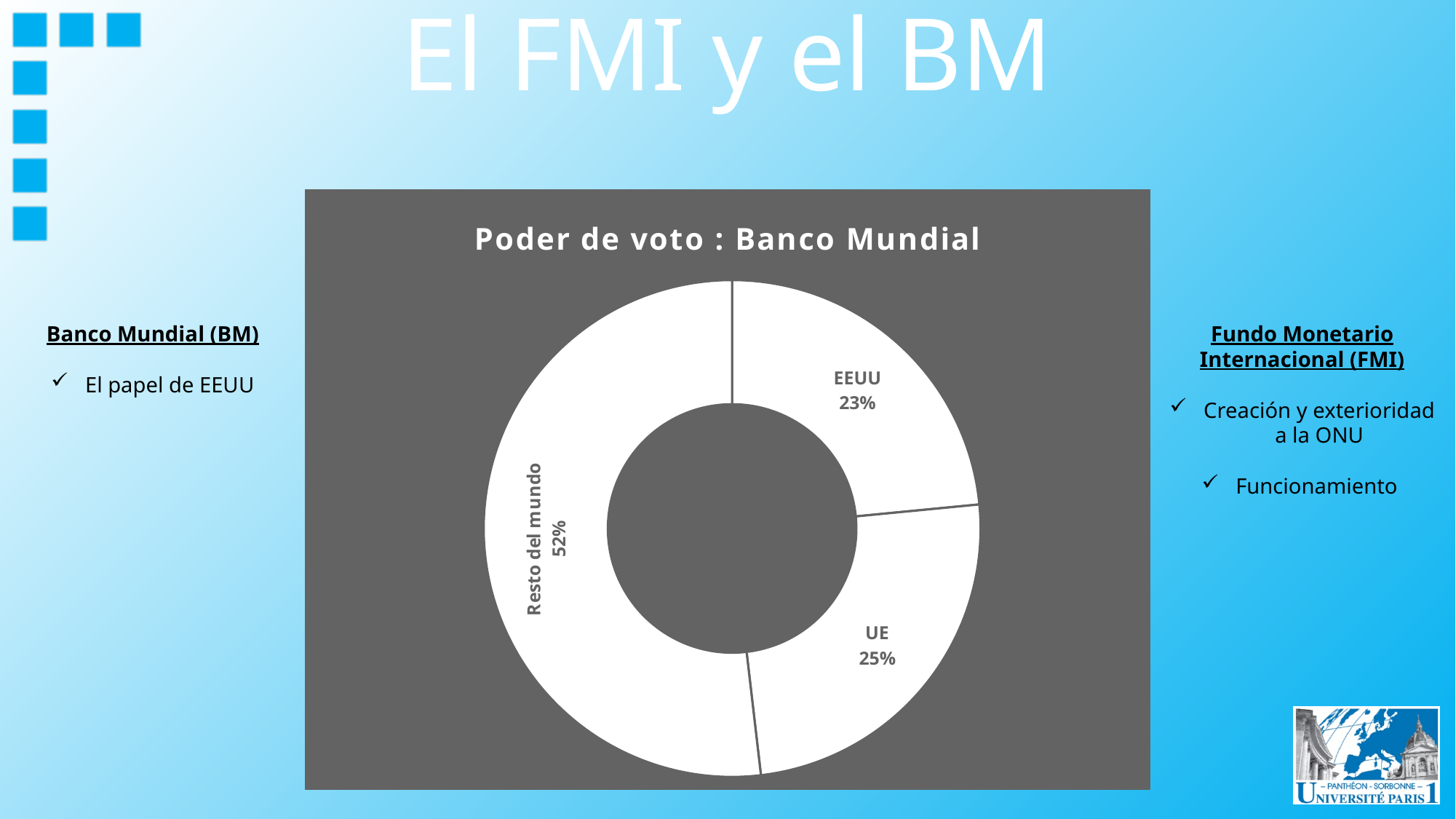
Which is larger, the share of Resto del mundo or the share of EEUU? Resto del mundo How many categories are shown in the chart? 3 Which category has the largest share in the chart? Resto del mundo What is the value for Resto del mundo in the chart? 52% What is the difference between the shares of Resto del mundo and UE? 27% What is the difference between the shares of UE and EEUU? 2% What is the value for UE in the chart? 25% Which category has the smallest share in the chart? EEUU What is the title of the chart? Poder de voto : Banco Mundial What is the combined share of EEUU and UE in the chart? 48% What is the value for EEUU in the chart? 23% What kind of chart is shown on the slide? Doughnut chart